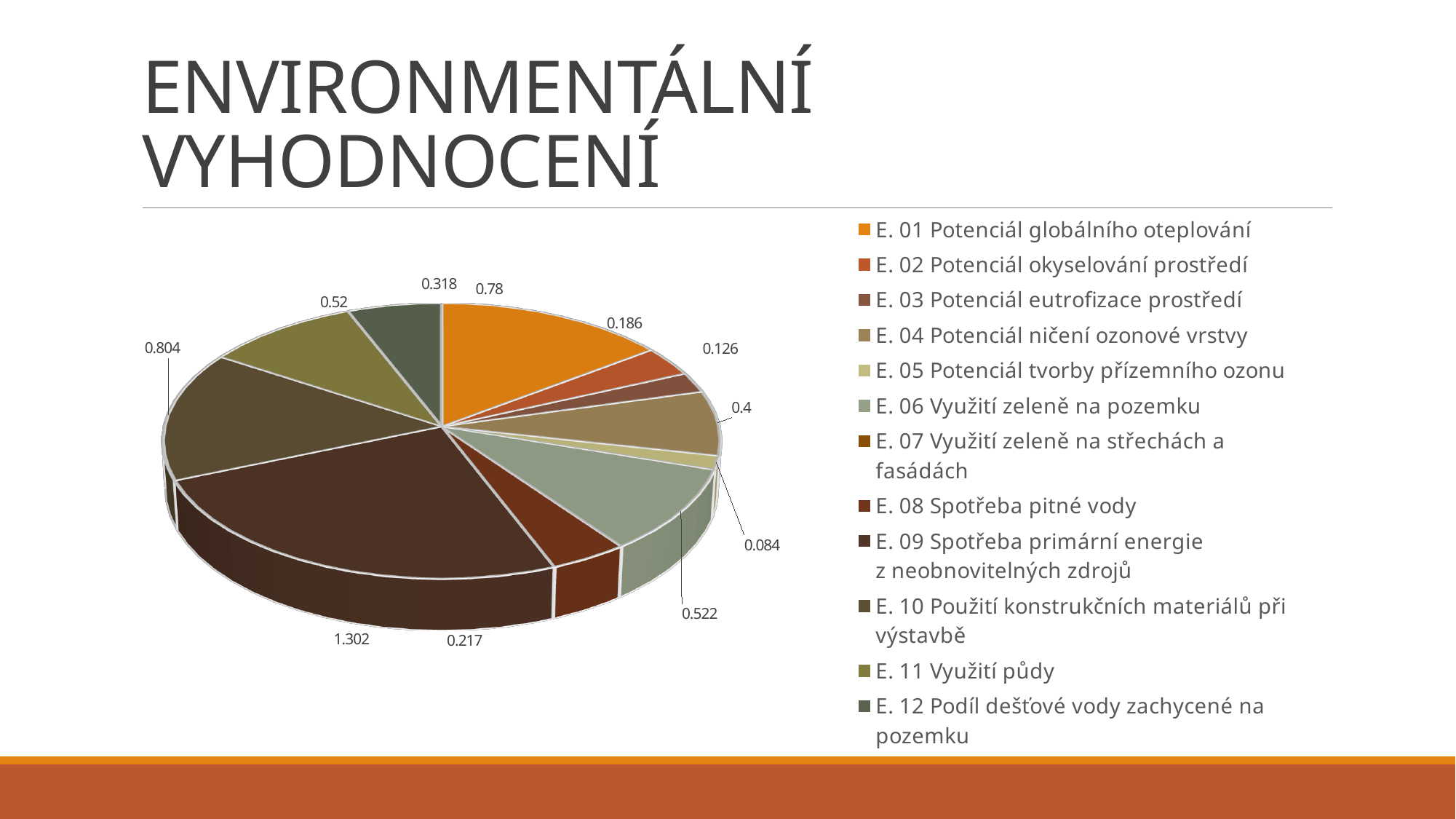
What is the value for E. 01 Potenciál globálního oteplování? 0.78 What is the title of the slide containing the pie chart? ENVIRONMENTÁLNÍ VYHODNOCENÍ What is the value for E. 12 Podíl dešťové vody zachycené na pozemku? 0.318 Which category has the largest slice in the pie chart? E. 09 Spotřeba primární energie z neobnovitelných zdrojů What is the difference between the values for E. 01 Potenciál globálního oteplování and E. 12 Podíl dešťové vody zachycené na pozemku? 0.462 What is the value for E. 10 Použití konstrukčních materiálů při výstavbě? 0.804 What kind of chart is shown on the slide? pie chart What is the value for E. 04 Potenciál ničení ozonové vrstvy? 0.4 How many entries does the chart legend list? 12 What is the smallest value labelled on the pie chart? 0.084 What is the value for E. 09 Spotřeba primární energie z neobnovitelných zdrojů? 1.302 Which is larger, the value for E. 01 Potenciál globálního oteplování or for E. 10 Použití konstrukčních materiálů při výstavbě? E. 10 Použití konstrukčních materiálů při výstavbě